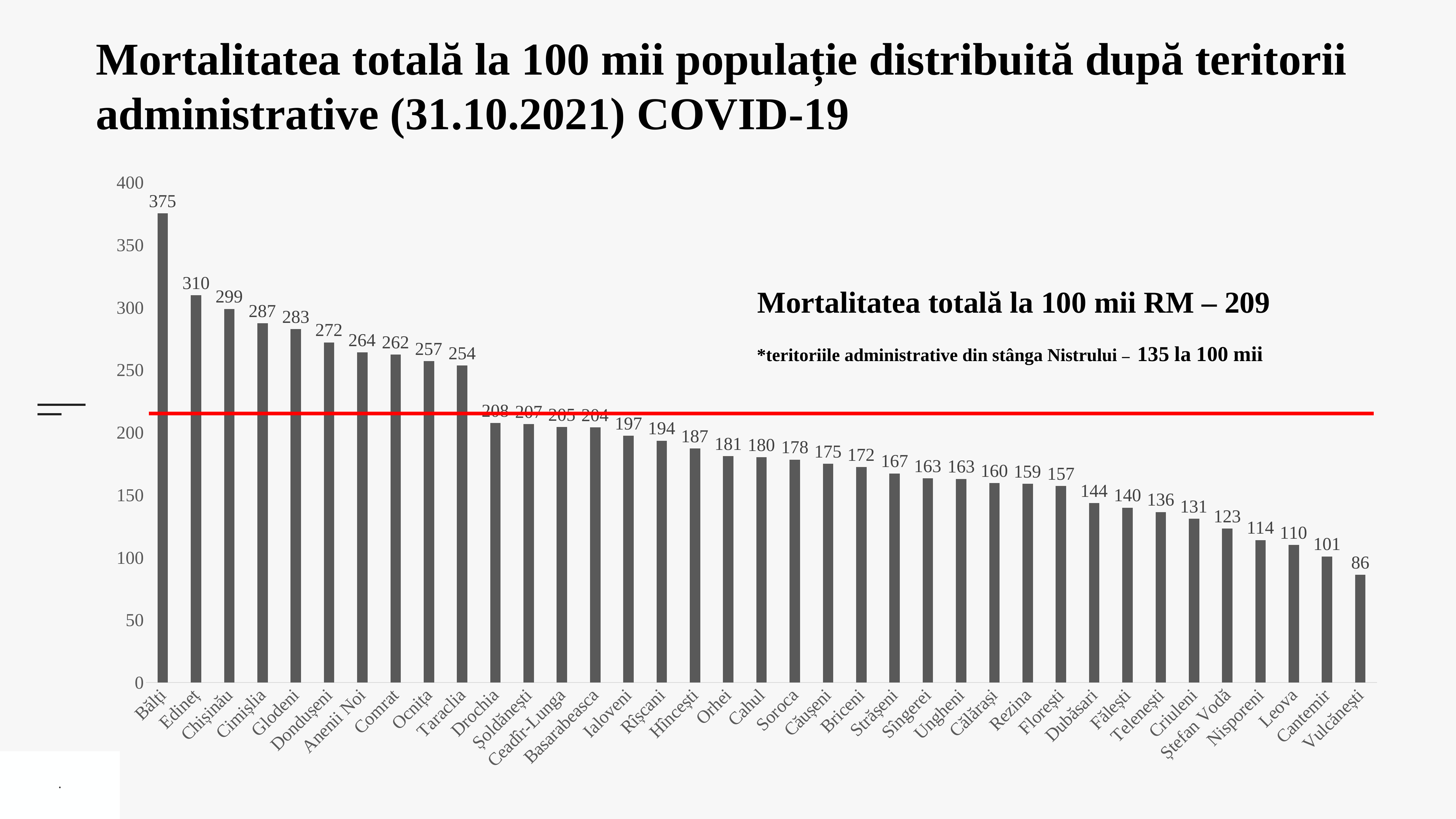
Do the values rise or fall from left to right along the x axis? Fall How many territories are shown on the chart? 37 What is the difference between the values for Bălți and Edineț? 65 What is the value for Cahul? 180 Which territory has the highest value? Bălți What kind of chart is shown on the slide? Bar chart Which has a larger value, Comrat or Drochia? Comrat What is the difference between the values for Cantemir and Vulcănești? 15 What is the value for Bălți? 375 Which territory has the lowest value? Vulcănești What is the value for Chișinău? 299 What is the value for Orhei? 181